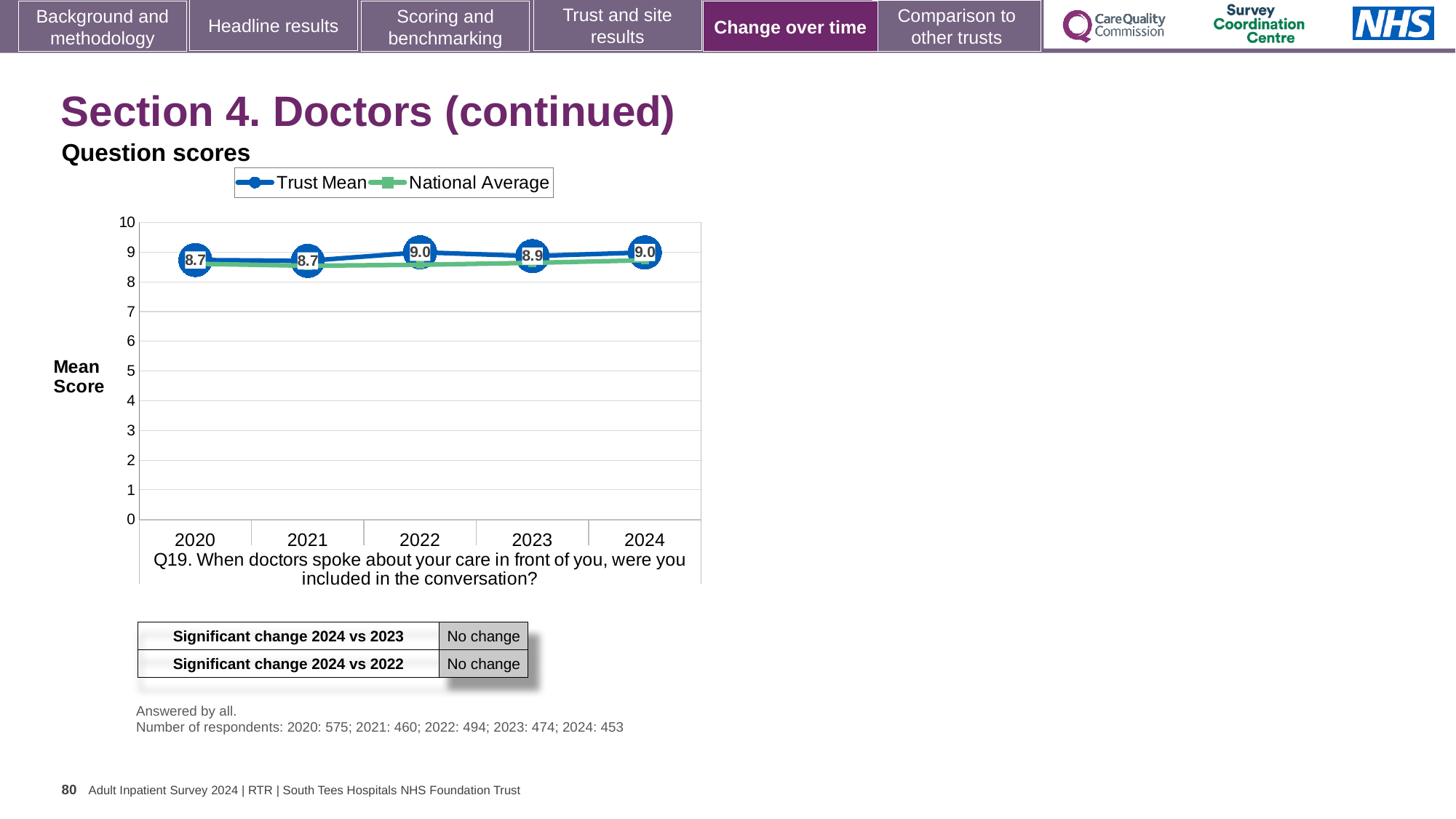
Does the Trust Mean score rise or fall overall from 2020 to 2024? rise What is the Trust Mean score for 2023? 8.9 What kind of chart is shown on the slide? line chart What is the Trust Mean score for 2020? 8.7 What is the Trust Mean score for 2024? 9.0 What is the difference between the Trust Mean score in 2024 and in 2020? 0.3 How many series does the legend list? 2 What is the label on the y axis of the chart? Mean Score What is the Trust Mean score for 2022? 9.0 Is the National Average value for 2020 greater or less than 8? greater How many years are plotted on the x axis? 5 Which year has the larger Trust Mean score, 2021 or 2022? 2022